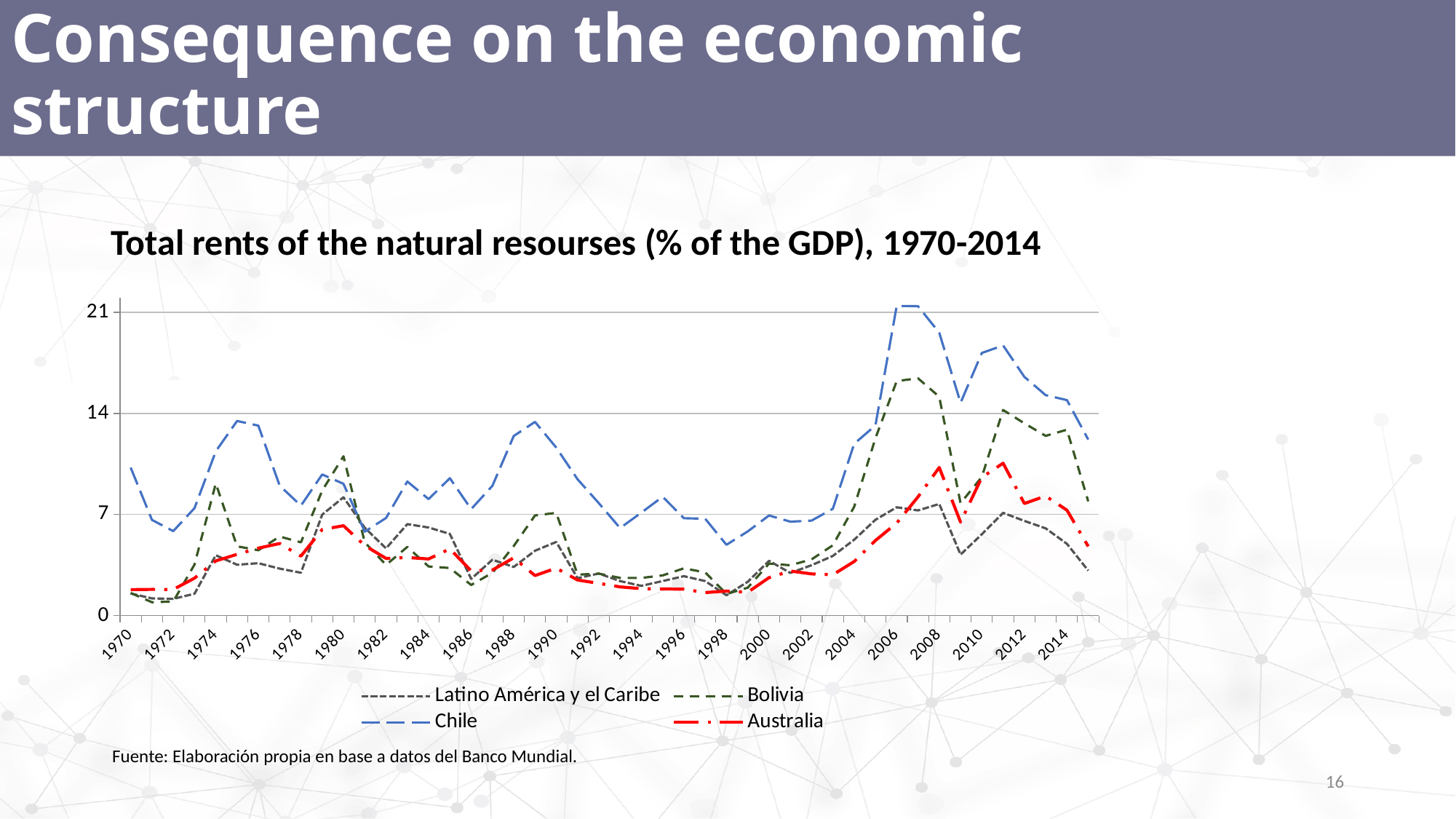
Which series has the lowest value in 2014? Latino América y el Caribe In 2007, which is larger: Chile or Australia? Chile Which series is drawn with the red line? Australia How many series does the legend list? 4 What kind of chart is shown on the slide? line chart Does the Chile series rise or fall between 2007 and 2014? fall Is the value for Bolivia in 2011 greater or less than 7? greater Which series reaches the highest value anywhere on the chart? Chile In 1975, which is larger: Chile or Latino América y el Caribe? Chile Is the value for Australia in 1998 greater or less than 7? less What is the title of the chart? Total rents of the natural resourses (% of the GDP), 1970-2014 Is the value for Chile in 2007 greater or less than 14? greater